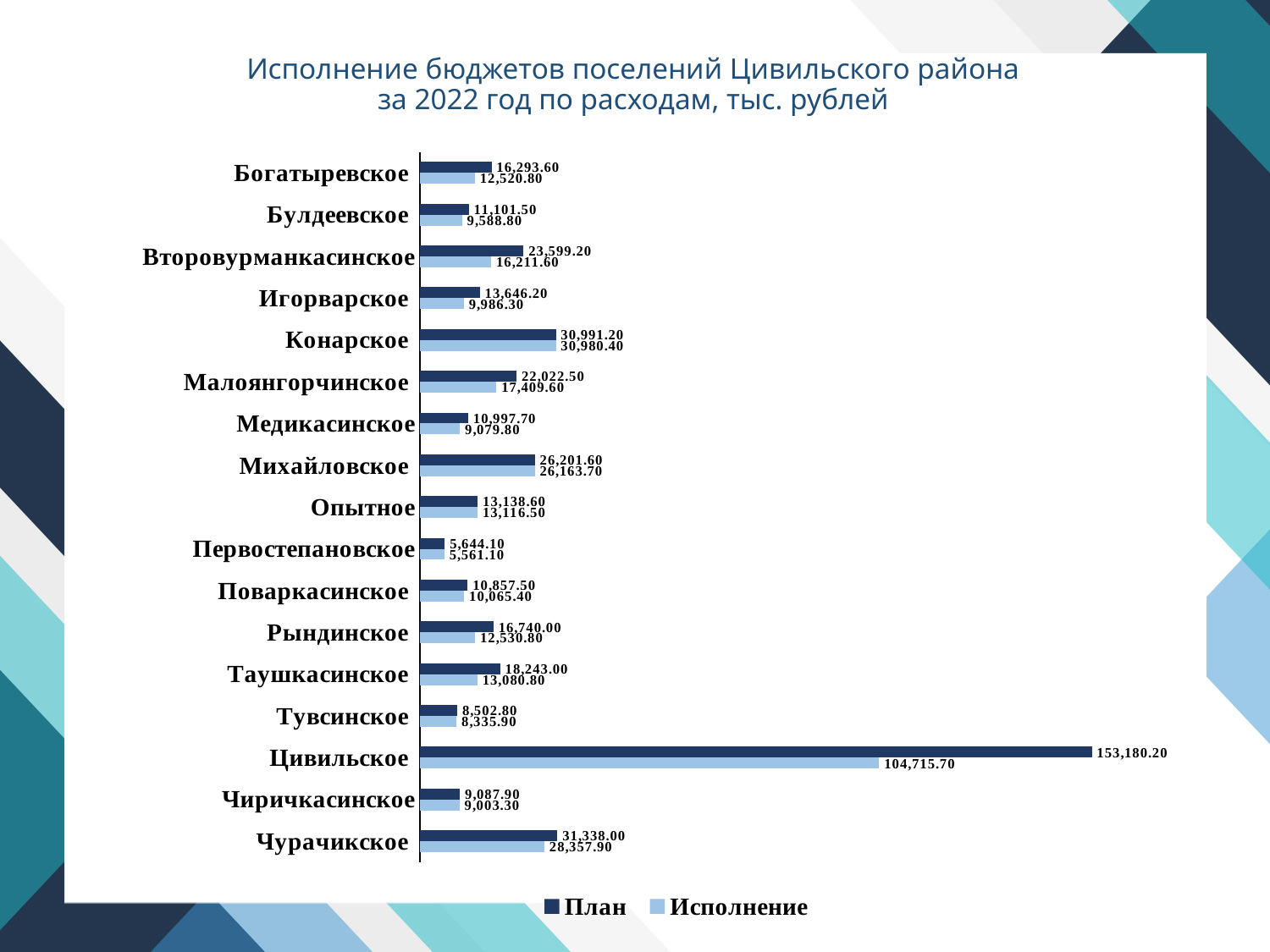
How many series does the legend list? 2 What is the Исполнение value for Конарское? 30,980.40 How many settlements (categories) are shown in the chart? 17 Which has the larger План value, Второвурманкасинское or Малоянгорчинское? Второвурманкасинское Which settlement has the lowest Исполнение value? Первостепановское Which settlement has the highest План value? Цивильское What is the Исполнение value for Таушкасинское? 13,080.80 What is the План value for Михайловское? 26,201.60 What type of chart is shown on the slide? Bar chart What is the difference between the План and Исполнение values for Цивильское? 48,464.50 What are the two series names shown in the legend? План and Исполнение What is the План value for Цивильское? 153,180.20